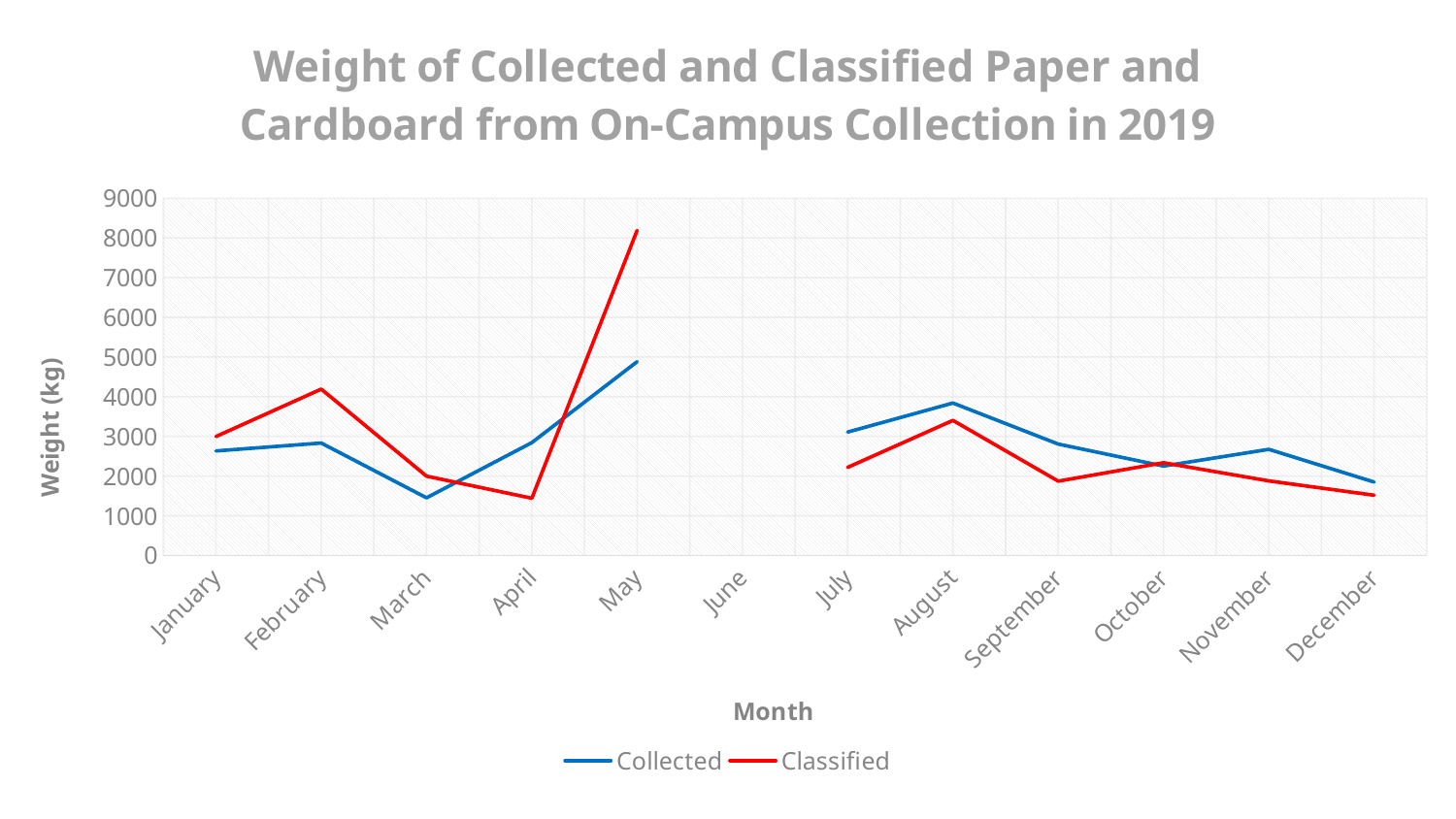
What kind of chart is shown on the slide? Line chart In February, which series has the larger value, Collected or Classified? Classified In which month is the Collected series at its lowest value? March Does the Collected series rise or fall from March to May? Rise How many series does the legend list? 2 What is the label of the vertical axis? Weight (kg) In which month does the Collected series reach its highest value? May In which month does the Classified series reach its highest value? May How many months are shown along the x axis? 12 Is the Collected value for March greater or less than 2000? less What are the two series named in the legend? Collected and Classified Is the Classified value for May greater or less than 8000? greater